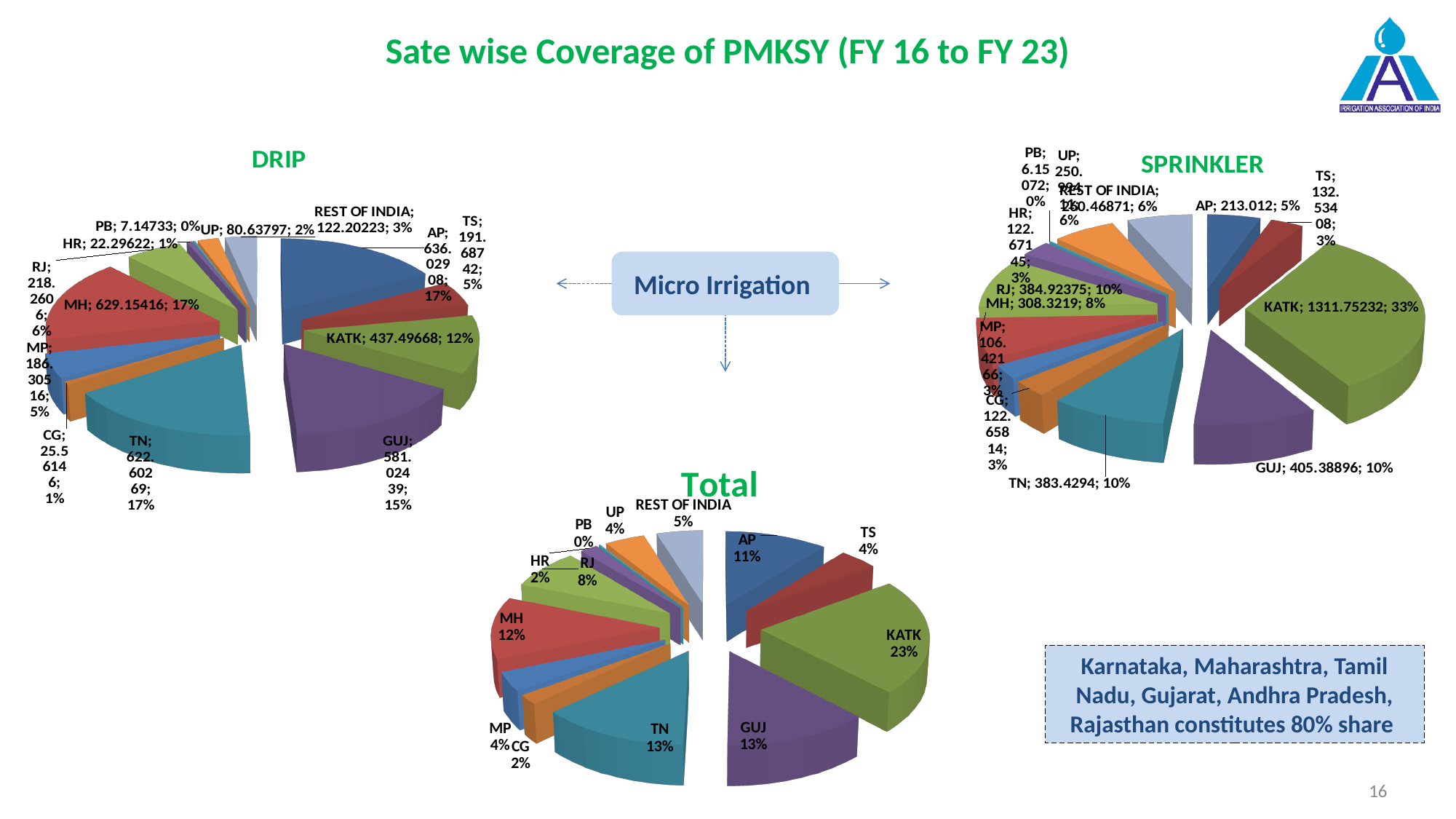
In the SPRINKLER pie chart, which state has the largest slice? KATK In the DRIP pie chart, what is the difference between the values for GUJ and KATK? 143.52771 In the SPRINKLER pie chart, what share does MH hold? 8% In the DRIP pie chart, what value is shown for KATK? 437.49668 In the SPRINKLER pie chart, what value is shown for KATK? 1311.75232 In the SPRINKLER pie chart, which is larger, GUJ or TN? GUJ In the DRIP pie chart, what share of the pie does GUJ hold? 15% How many categories are shown in the Total pie chart? 13 In the DRIP pie chart, which state has the smallest slice? PB What kind of chart is the Total chart? Pie chart In the Total pie chart, what share does TN hold? 13%